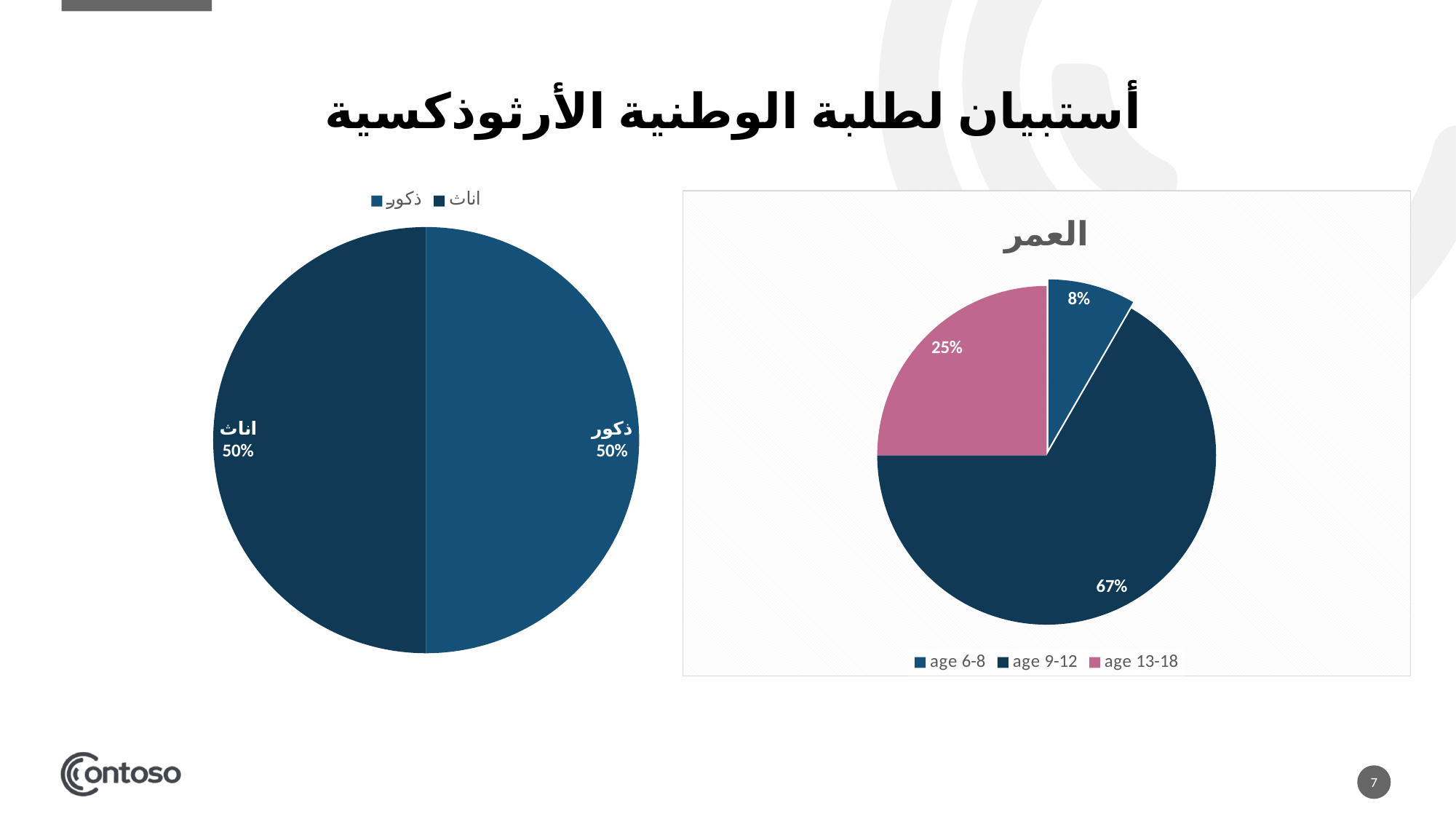
How many slices does the pie chart titled العمر on the right have? 3 In the pie chart titled العمر on the right, what is the difference in percentage points between age 9-12 and age 13-18? 42 In the pie chart titled العمر on the right, which age group has the largest slice? age 9-12 How many entries does the legend of the pie chart on the left list? 2 In the pie chart titled العمر on the right, which age group has the smallest slice? age 6-8 In the pie chart titled العمر on the right, what share is labelled for age 13-18? 25% In the pie chart titled العمر on the right, what share is labelled for age 9-12? 67% In the pie chart titled العمر on the right, what share is labelled for age 6-8? 8% In the pie chart titled العمر on the right, which is larger, the slice for age 13-18 or the slice for age 6-8? age 13-18 In the pie chart on the left, what share is labelled for ذكور? 50% What type of chart is shown on the left of the slide? Pie chart In the pie chart on the left, what share is labelled for اناث? 50%